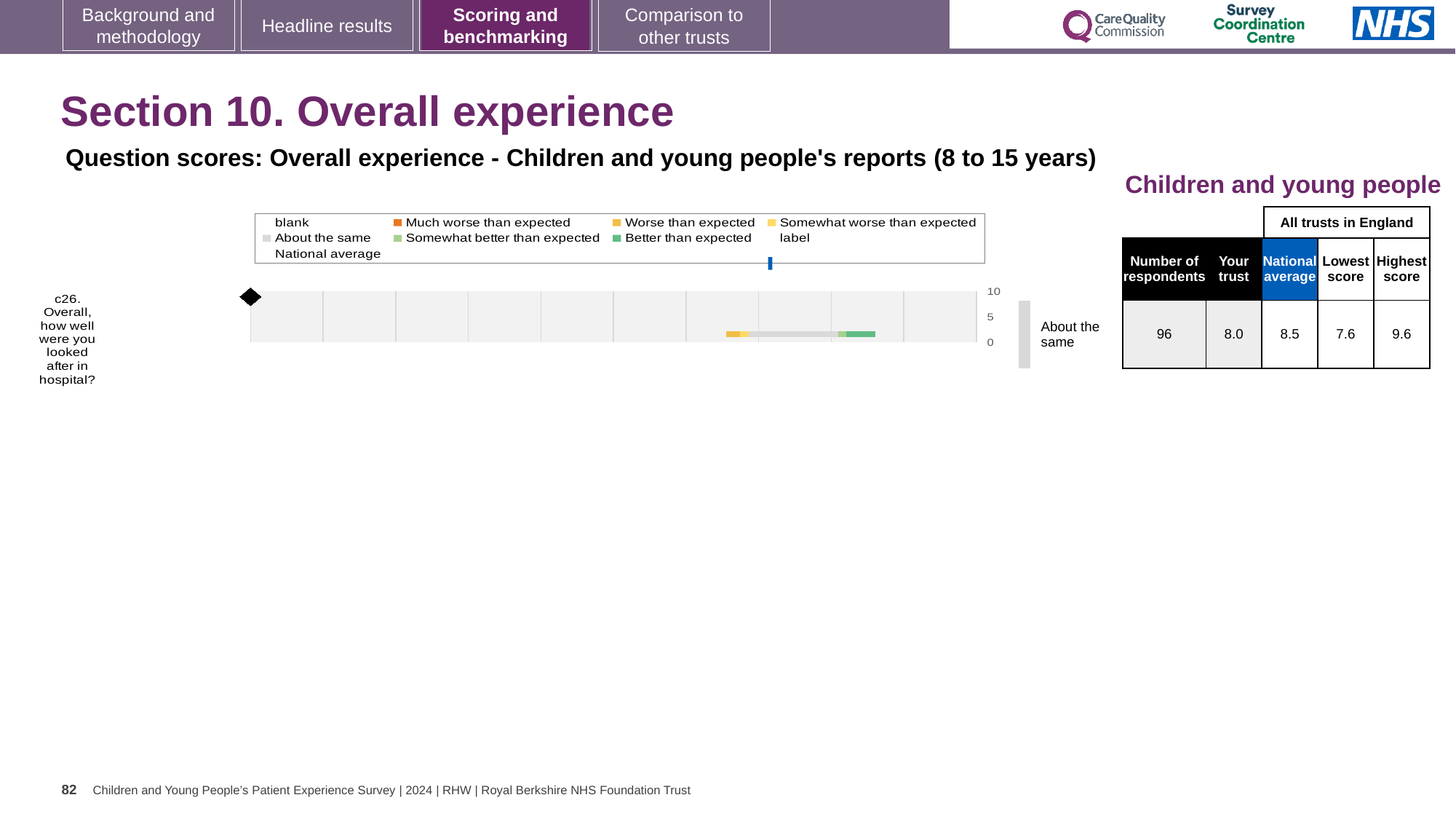
What is the difference between the highest and lowest scores across all trusts in England for question c26? 2.0 Which benchmark category is the trust's result for question c26 placed in? About the same What kind of chart is used to show the question score for c26? bar chart Which is larger for question c26, the trust's score or the national average? National average What is the lowest score among all trusts in England for question c26? 7.6 What is the difference between the national average and the trust's score for question c26? 0.5 How many respondents answered question c26? 96 Which legend entry is shown in orange? Much worse than expected What is the highest score among all trusts in England for question c26? 9.6 How many questions are plotted in the chart? 1 What is the national average score for question c26? 8.5 What is the 'Your trust' score for question c26 (Overall, how well were you looked after in hospital?)? 8.0